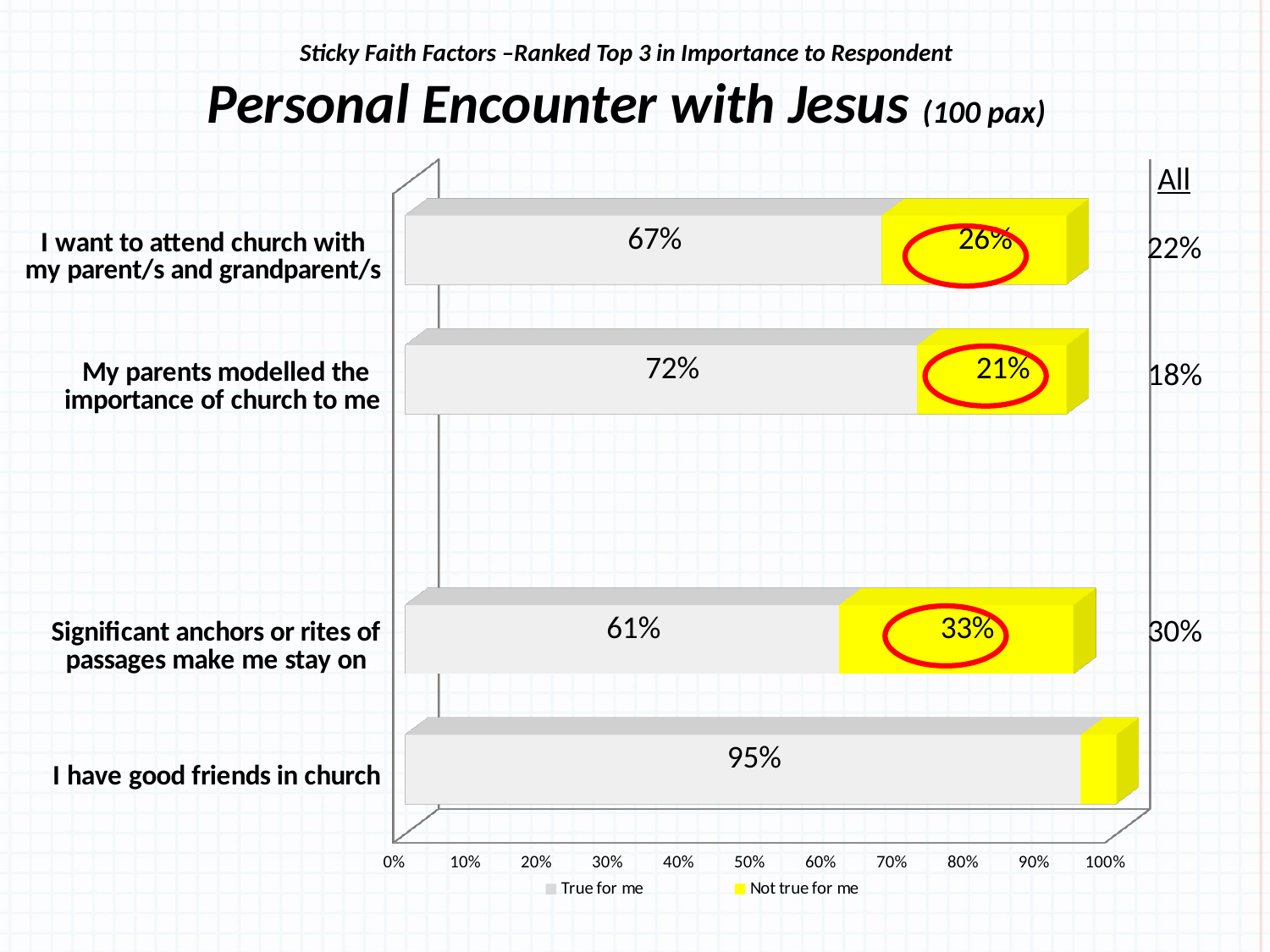
How many categories are plotted in the chart? 4 Which is larger: the 'Not true for me' value for 'Significant anchors or rites of passages make me stay on' or for 'My parents modelled the importance of church to me'? Significant anchors or rites of passages make me stay on Which category has the highest 'True for me' value? I have good friends in church What is the 'Not true for me' value for 'Significant anchors or rites of passages make me stay on'? 33% What is the difference between the 'True for me' values for 'My parents modelled the importance of church to me' and 'I want to attend church with my parent/s and grandparent/s'? 5% How many series does the legend list? 2 What is the 'Not true for me' value for 'I want to attend church with my parent/s and grandparent/s'? 26% What is the 'True for me' value for 'My parents modelled the importance of church to me'? 72% Which category has the lowest 'True for me' value? Significant anchors or rites of passages make me stay on What kind of chart is shown on the slide? bar chart What colour represents the 'Not true for me' series in the chart? yellow What is the 'True for me' value for 'I have good friends in church'? 95%